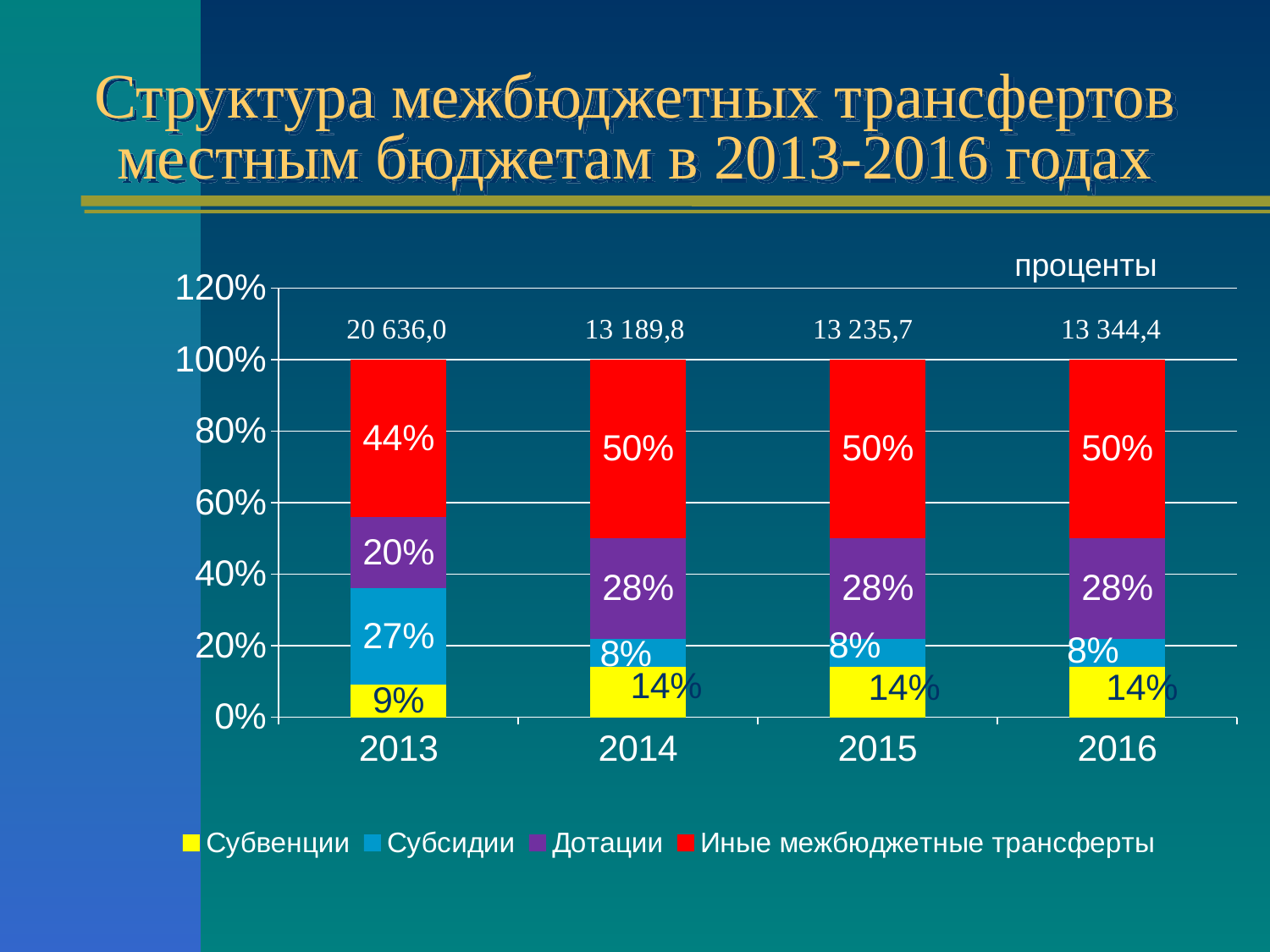
In which year is the share of Субсидии highest? 2013 What share do Иные межбюджетные трансферты make up in 2014? 50% What total value is printed above the bar for 2016? 13 344,4 What share do Дотации make up in 2015? 28% In which year is the share of Иные межбюджетные трансферты lowest? 2013 What share do Субвенции make up in 2013? 9% What kind of chart is shown on the slide? Stacked bar chart Which is larger in 2013: the share of Субсидии or the share of Дотации? Субсидии By how many percentage points does the share of Субсидии in 2013 exceed the share in 2014? 19 percentage points What total value is printed above the bar for 2013? 20 636,0 What share do Субсидии make up in 2013? 27% How many series does the legend list? 4